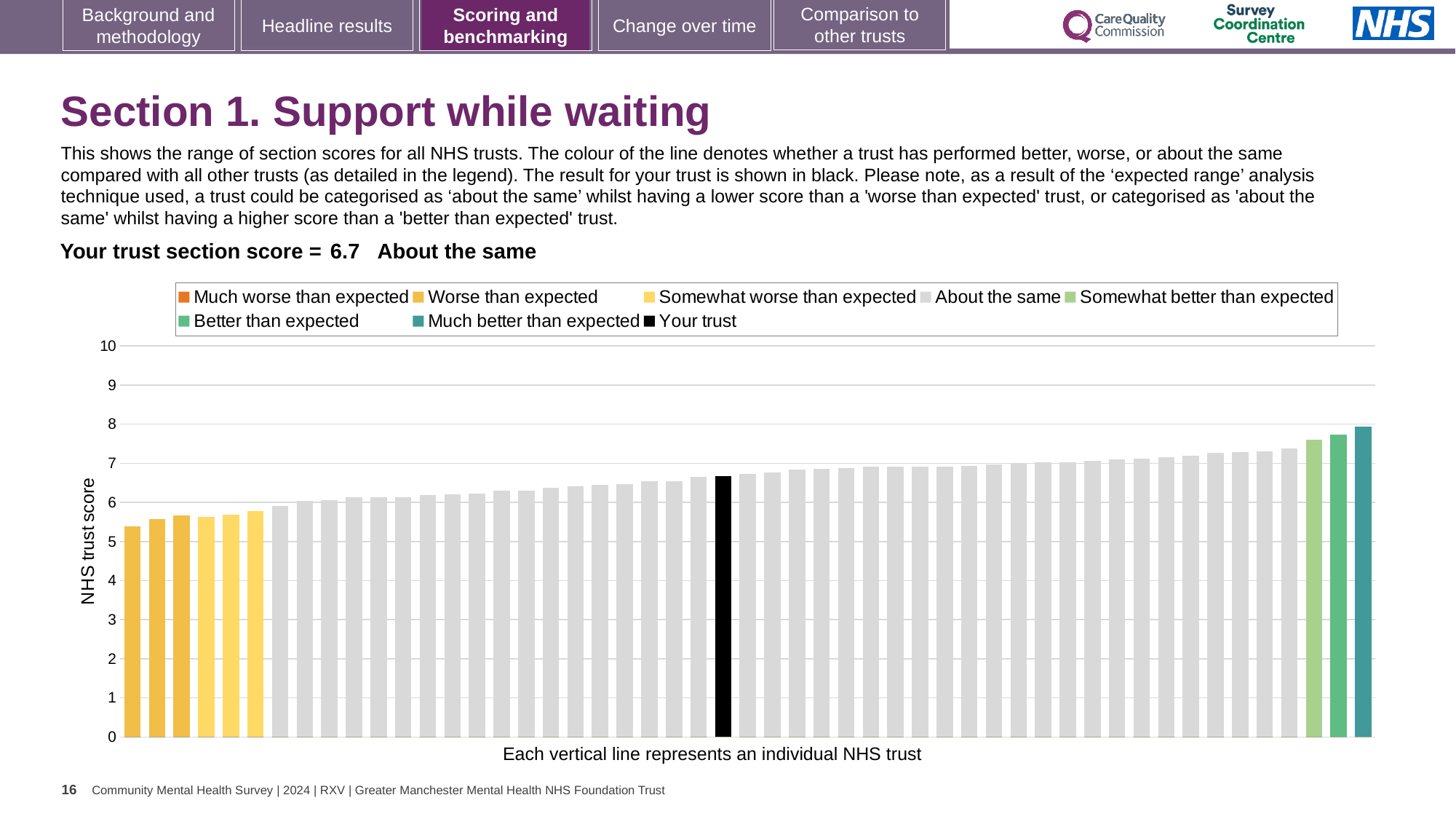
Is the value of the highest bar in the chart greater or less than 7? greater Is the value for your trust (the black bar) greater or less than 6? greater Do the bar values rise or fall from left to right along the x axis? rise Is the value of the lowest bar in the chart greater or less than 6? less What colour is used for the bar representing your trust? black What is the label on the vertical axis of the chart? NHS trust score Which legend category does the tallest bar in the chart belong to? Much better than expected How many entries does the chart legend list? 8 Which performance category is your trust placed in for this section? About the same What kind of chart is shown on the slide? bar chart What is the section score for your trust shown on the slide? 6.7